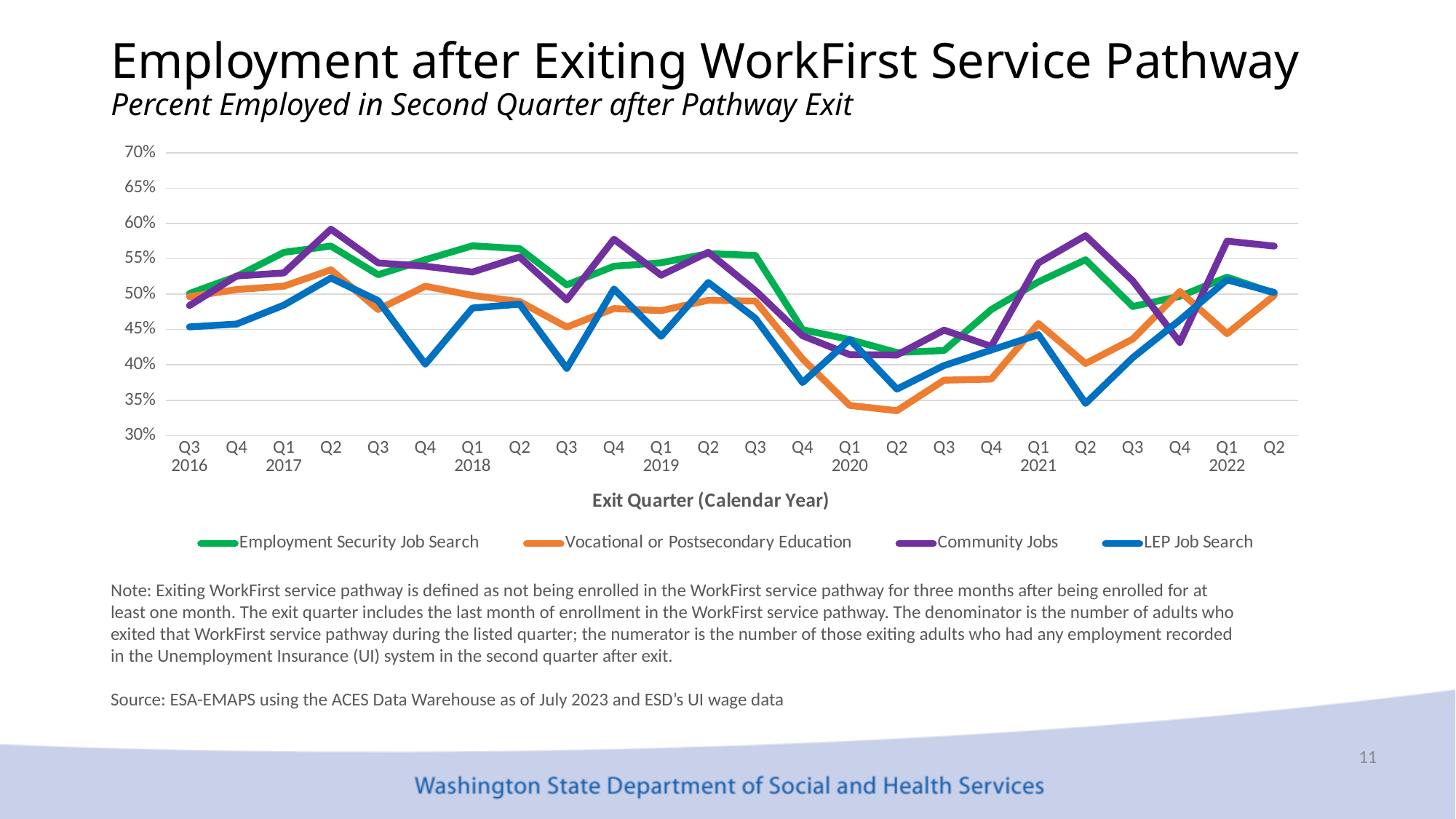
Is the value for Employment Security Job Search in Q1 2018 greater or less than 55%? greater In Q2 2021, which is larger: Employment Security Job Search or LEP Job Search? Employment Security Job Search Is the value for LEP Job Search in Q4 2019 greater or less than 40%? less Which series has the lowest value in Q2 2020? Vocational or Postsecondary Education Does the Vocational or Postsecondary Education line rise or fall from Q3 2019 to Q2 2020? Fall How many series does the legend list? 4 Is the value for Community Jobs in Q2 2017 greater or less than 55%? greater What is the label of the x axis? Exit Quarter (Calendar Year) How many exit quarters are plotted along the x axis? 24 Which series has the highest value in Q2 2017? Community Jobs What kind of chart is shown on the slide? Line chart